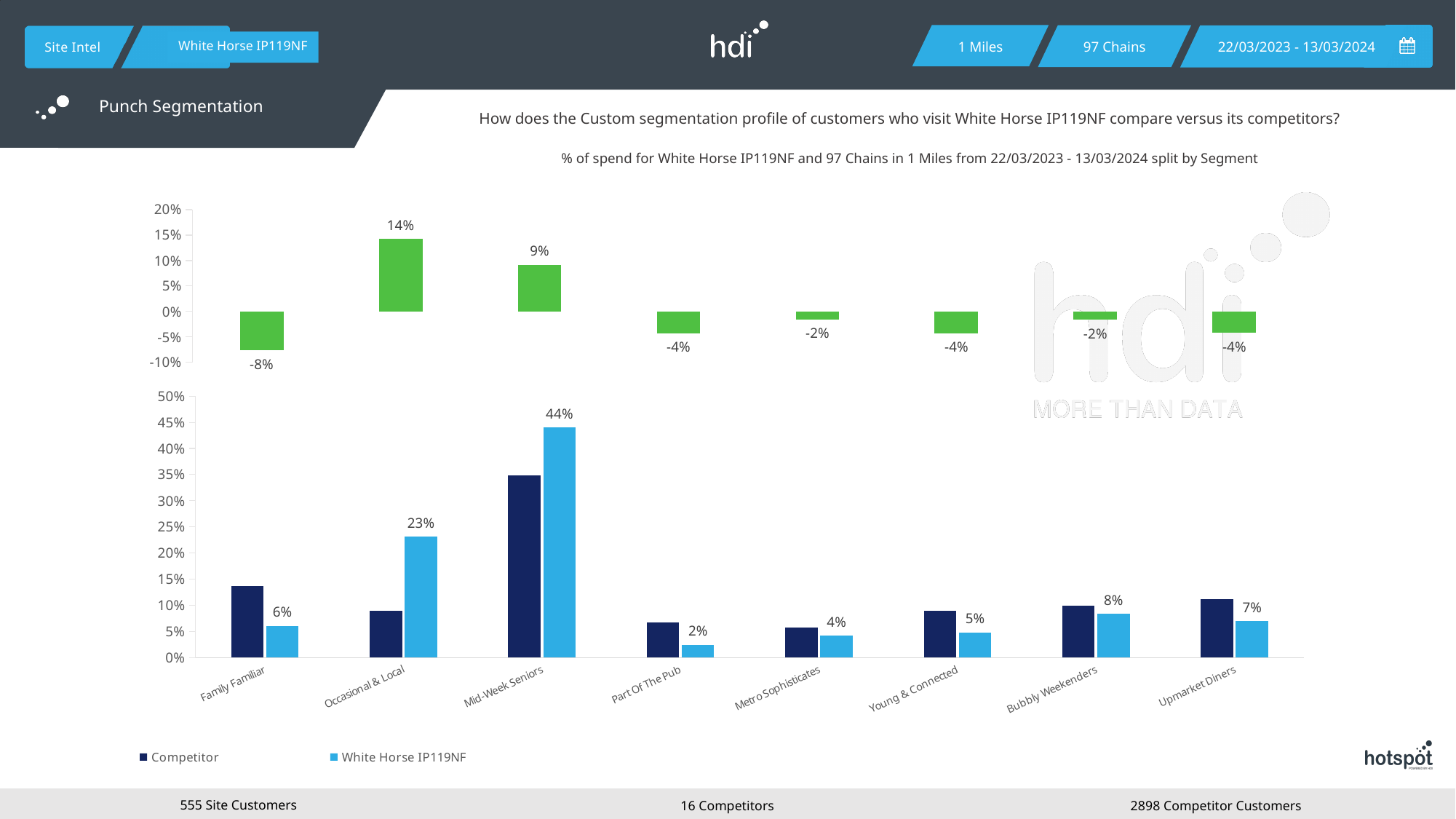
In the top chart, what is the value shown for Family Familiar? -8% What type of chart is the bottom chart? Bar chart In the bottom chart, what is the value for White Horse IP119NF in the Mid-Week Seniors segment? 44% In the top chart, which segment has the highest value? Occasional & Local In the bottom chart, which segment has the lowest White Horse IP119NF value? Part Of The Pub In the bottom chart, what is the difference between the White Horse IP119NF values for Mid-Week Seniors and Occasional & Local? 21% How many series does the legend of the bottom chart list? 2 In the bottom chart, what is the value for White Horse IP119NF in the Occasional & Local segment? 23% In the top chart, which segment has the lowest value? Family Familiar In the bottom chart, for Family Familiar, which is larger: the Competitor bar or the White Horse IP119NF bar? Competitor How many segments are shown on the x axis of the bottom chart? 8 In the bottom chart, is the Competitor value for Mid-Week Seniors greater or less than 30%? greater